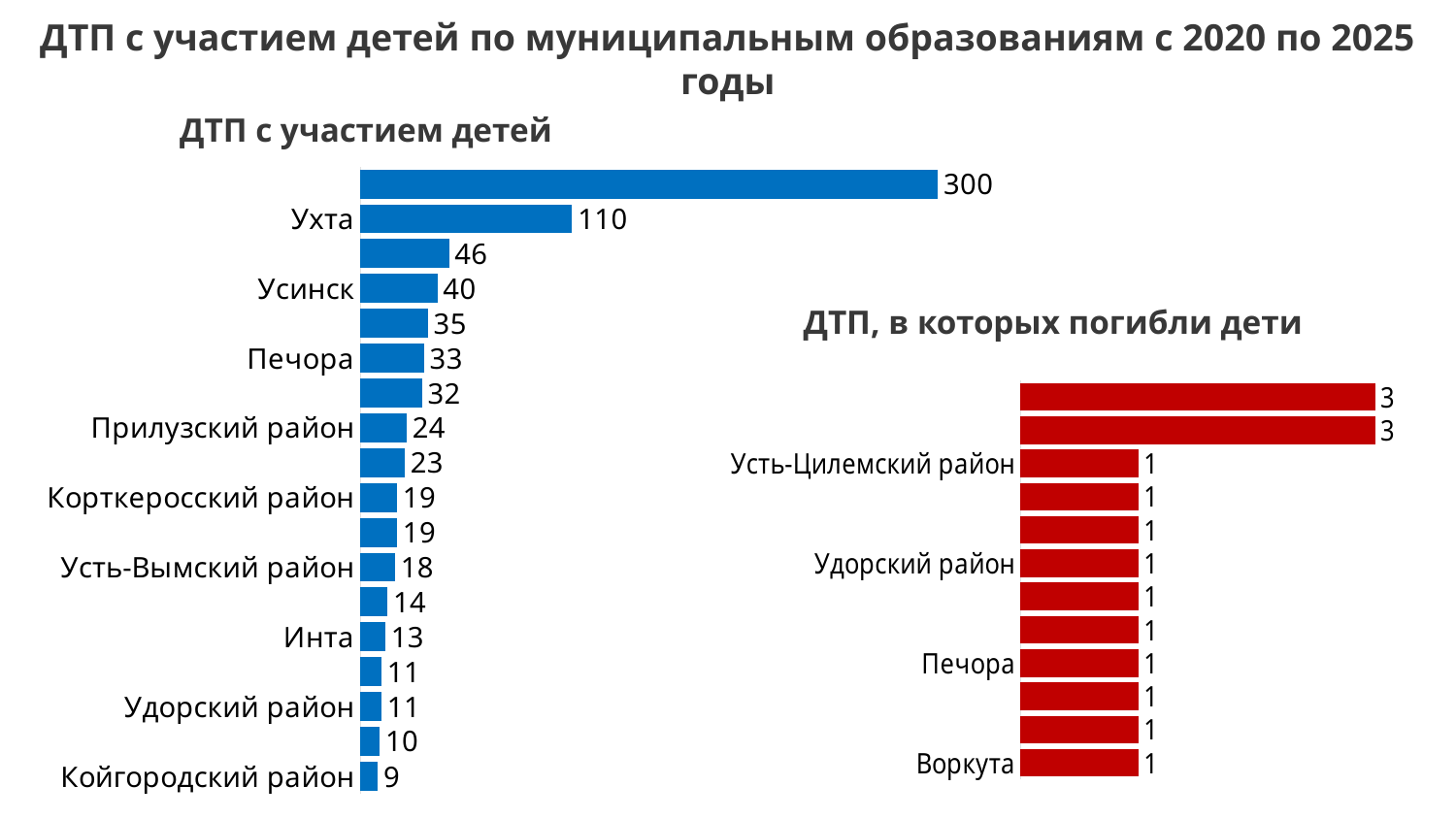
In the chart titled "ДТП с участием детей", what is the value for Ухта? 110 In the chart titled "ДТП с участием детей", which is larger, the value for Печора or the value for Прилузский район? Печора In the chart titled "ДТП с участием детей", what is the difference between the values for Ухта and Усинск? 70 In the chart titled "ДТП, в которых погибли дети", what is the value for Печора? 1 In the chart titled "ДТП, в которых погибли дети", what is the value for Усть-Цилемский район? 1 In the chart titled "ДТП с участием детей", which labelled category has the lowest value? Койгородский район In the chart titled "ДТП с участием детей", what is the value for Койгородский район? 9 In the chart titled "ДТП с участием детей", how many bars are plotted? 18 In the chart titled "ДТП с участием детей", what is the value for Усинск? 40 In the chart titled "ДТП с участием детей", what is the value for Инта? 13 In the chart titled "ДТП, в которых погибли дети", how many bars are plotted? 12 What kind of chart is the chart titled "ДТП, в которых погибли дети"? Bar chart